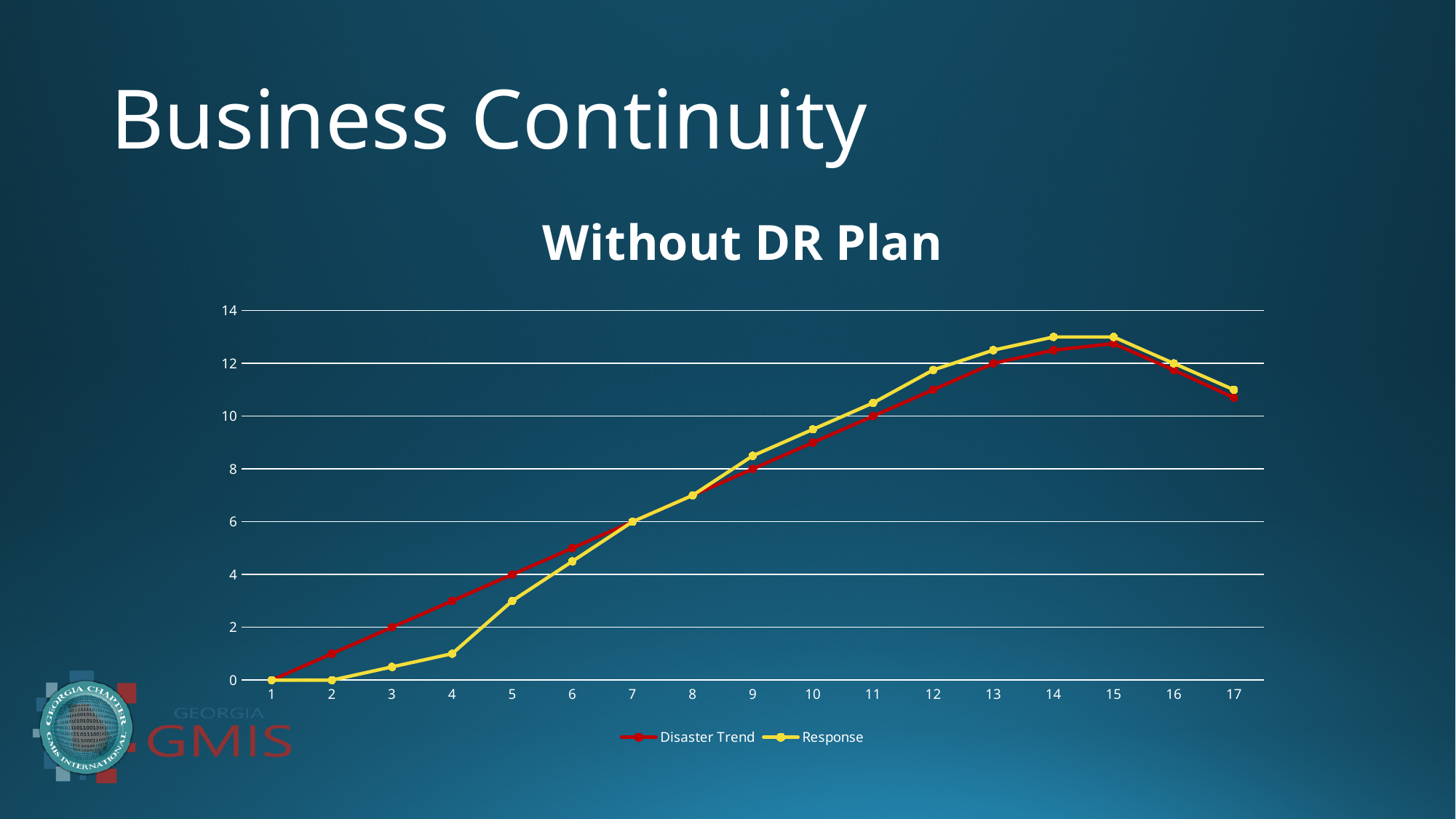
What kind of chart is shown under the title "Without DR Plan"? line chart What is the value of the Response series at x = 2? 0 At x = 12, which series has the larger value, Disaster Trend or Response? Response At x = 5, which series has the larger value, Disaster Trend or Response? Disaster Trend How many points are plotted along the x axis of the "Without DR Plan" chart? 17 Is the value of the Response series at x = 4 greater or less than 2? less What is the value of the Disaster Trend series at x = 3? 2 By how much does the Disaster Trend series increase from x = 3 to x = 13? 10 Is the value of the Disaster Trend series at x = 15 greater or less than 12? greater How many series does the legend of the "Without DR Plan" chart list? 2 What is the value of the Response series at x = 16? 12 What is the value of the Disaster Trend series at x = 13? 12